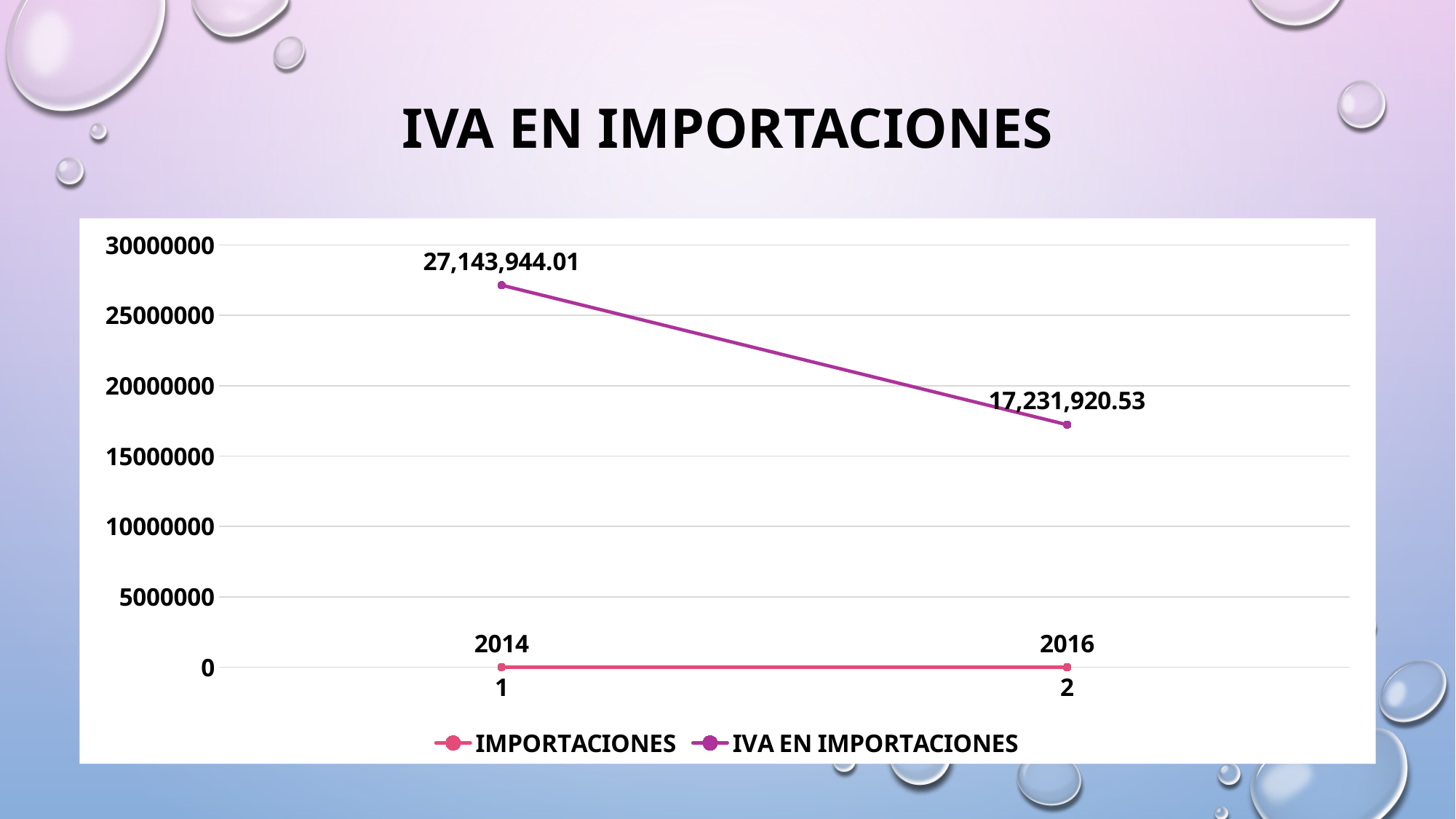
Is the IVA EN IMPORTACIONES value at category 2 greater or less than 20000000? less At which category does the IVA EN IMPORTACIONES series reach its lowest value? 2 How many series does the legend list? 2 Does the IVA EN IMPORTACIONES series rise or fall from category 1 to category 2? fall What kind of chart is shown on the slide? line chart Which is larger for the IVA EN IMPORTACIONES series: the value at category 1 or at category 2? category 1 What is the title of the slide? IVA EN IMPORTACIONES What is the value of the IVA EN IMPORTACIONES series at category 2? 17,231,920.53 How many categories are shown on the x axis? 2 At which category does the IVA EN IMPORTACIONES series reach its highest value? 1 What is the value of the IVA EN IMPORTACIONES series at category 1? 27,143,944.01 What is the difference between the IVA EN IMPORTACIONES values at category 1 and category 2? 9,912,023.48